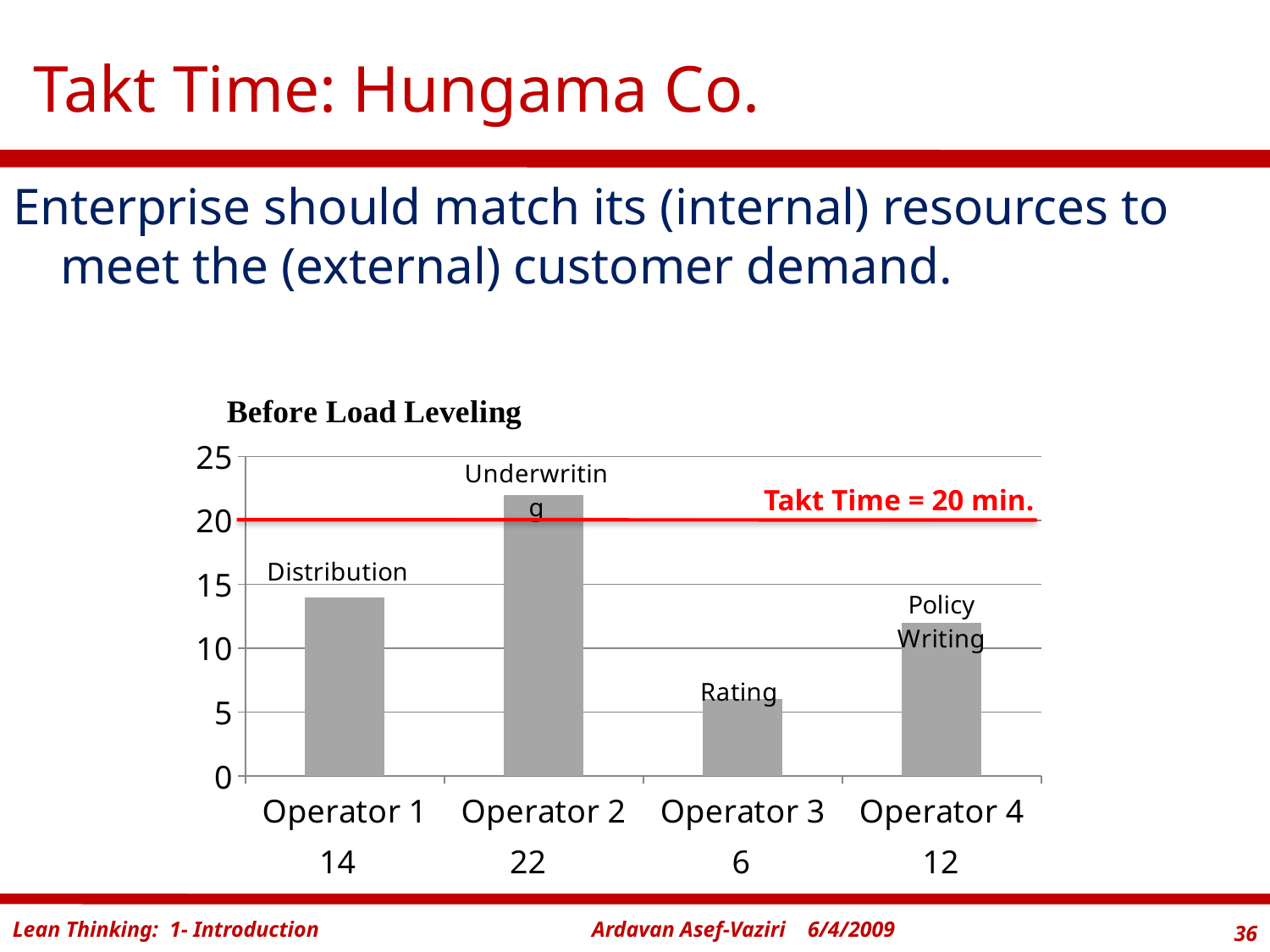
What kind of chart is shown on the slide? bar chart Which operator has the highest value? Operator 2 How many operators are shown on the x axis? 4 Which operator has the lowest value? Operator 3 What is the title of the chart? Before Load Leveling What is the value for Operator 2? 22 Is the value for Operator 2 greater or less than 20? greater Which is larger, the value for Operator 1 or the value for Operator 4? Operator 1 What is the value for Operator 3? 6 What Takt Time does the red line on the chart represent? 20 min. What is the difference between the values for Operator 2 and Operator 4? 10 What is the value for Operator 1? 14